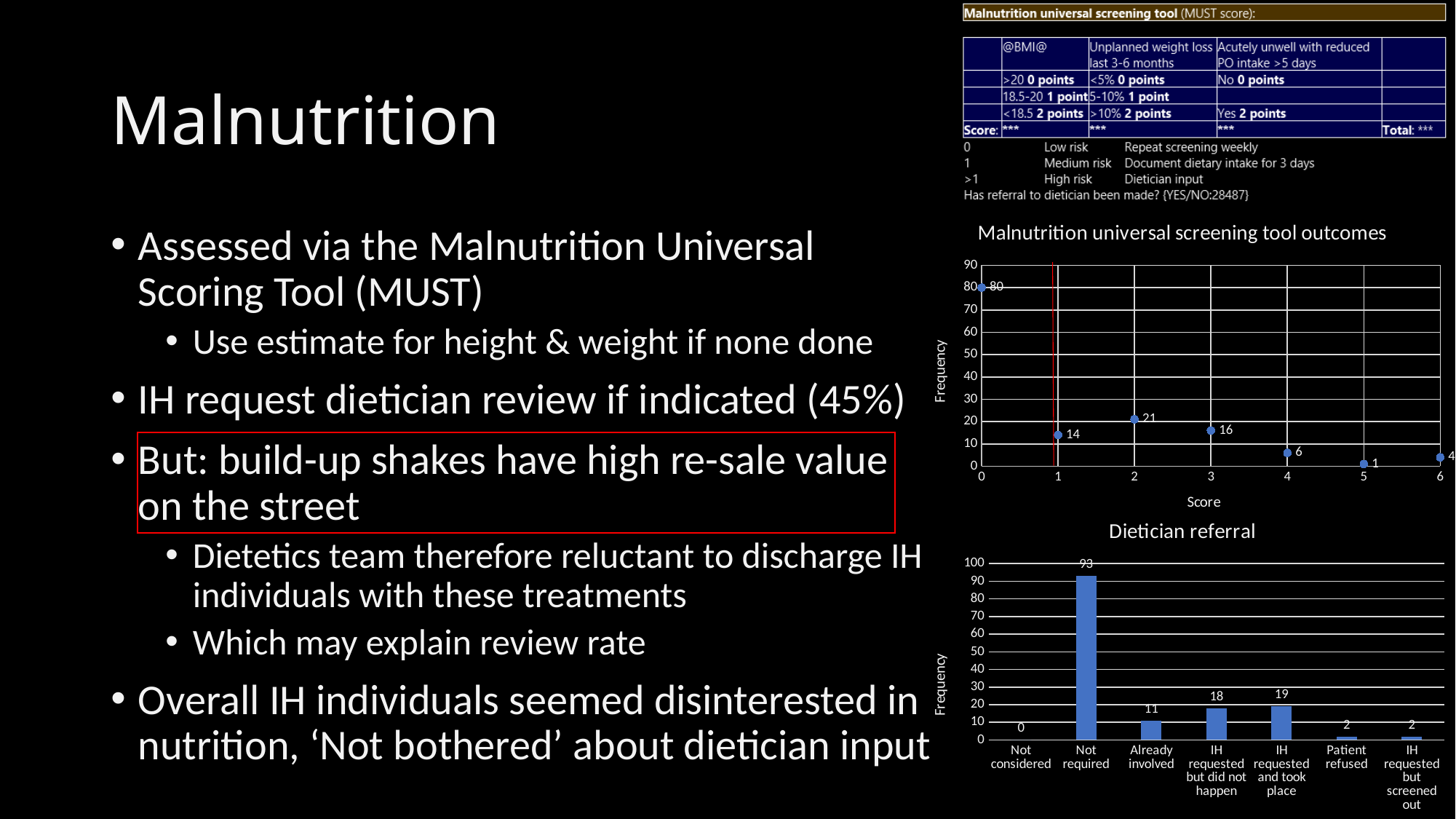
In the 'Dietician referral' chart, which is larger: 'Already involved' or 'IH requested but did not happen'? IH requested but did not happen In the 'Malnutrition universal screening tool outcomes' chart, what is the frequency for a score of 2? 21 In the 'Dietician referral' chart, what is the frequency for 'Not required'? 93 In the 'Malnutrition universal screening tool outcomes' chart, what is the label of the x axis? Score In the 'Malnutrition universal screening tool outcomes' chart, which score has the lowest frequency? 5 In the 'Malnutrition universal screening tool outcomes' chart, how many data points are plotted? 7 In the 'Dietician referral' chart, what is the difference between 'Not required' and 'Already involved'? 82 What kind of chart is the 'Dietician referral' chart? Bar chart In the 'Dietician referral' chart, which category has the highest frequency? Not required In the 'Malnutrition universal screening tool outcomes' chart, what is the difference in frequency between score 1 and score 3? 2 In the 'Malnutrition universal screening tool outcomes' chart, what is the frequency for a score of 0? 80 In the 'Dietician referral' chart, what is the frequency for 'IH requested and took place'? 19